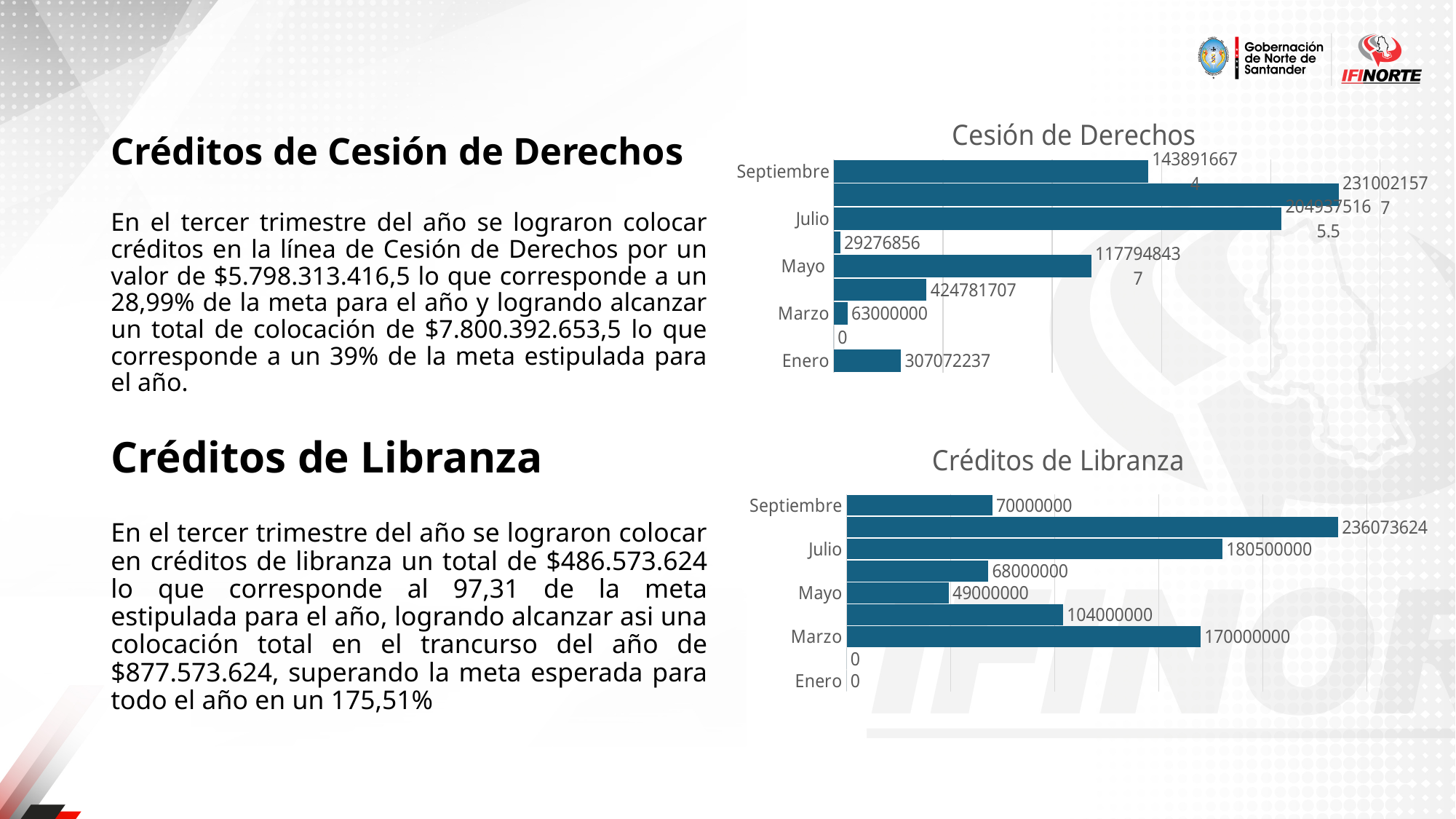
In the Créditos de Libranza chart, what is the difference between the values for Julio and Septiembre? 110500000 In the Cesión de Derechos chart, what is the value for Enero? 307072237 In the Créditos de Libranza chart, which is larger, the value for Marzo or the value for Julio? Julio In the Créditos de Libranza chart, what is the value for Marzo? 170000000 What kind of chart is the Créditos de Libranza chart? Bar chart In the Cesión de Derechos chart, what is the difference between the values for Enero and Marzo? 244072237 In the Créditos de Libranza chart, what is the value for Enero? 0 In the Créditos de Libranza chart, what is the value for Mayo? 49000000 In the Créditos de Libranza chart, what is the value for Septiembre? 70000000 In the Cesión de Derechos chart, what is the value for Marzo? 63000000 In the Cesión de Derechos chart, which is larger, the value for Enero or the value for Marzo? Enero In the Créditos de Libranza chart, what is the value for Julio? 180500000